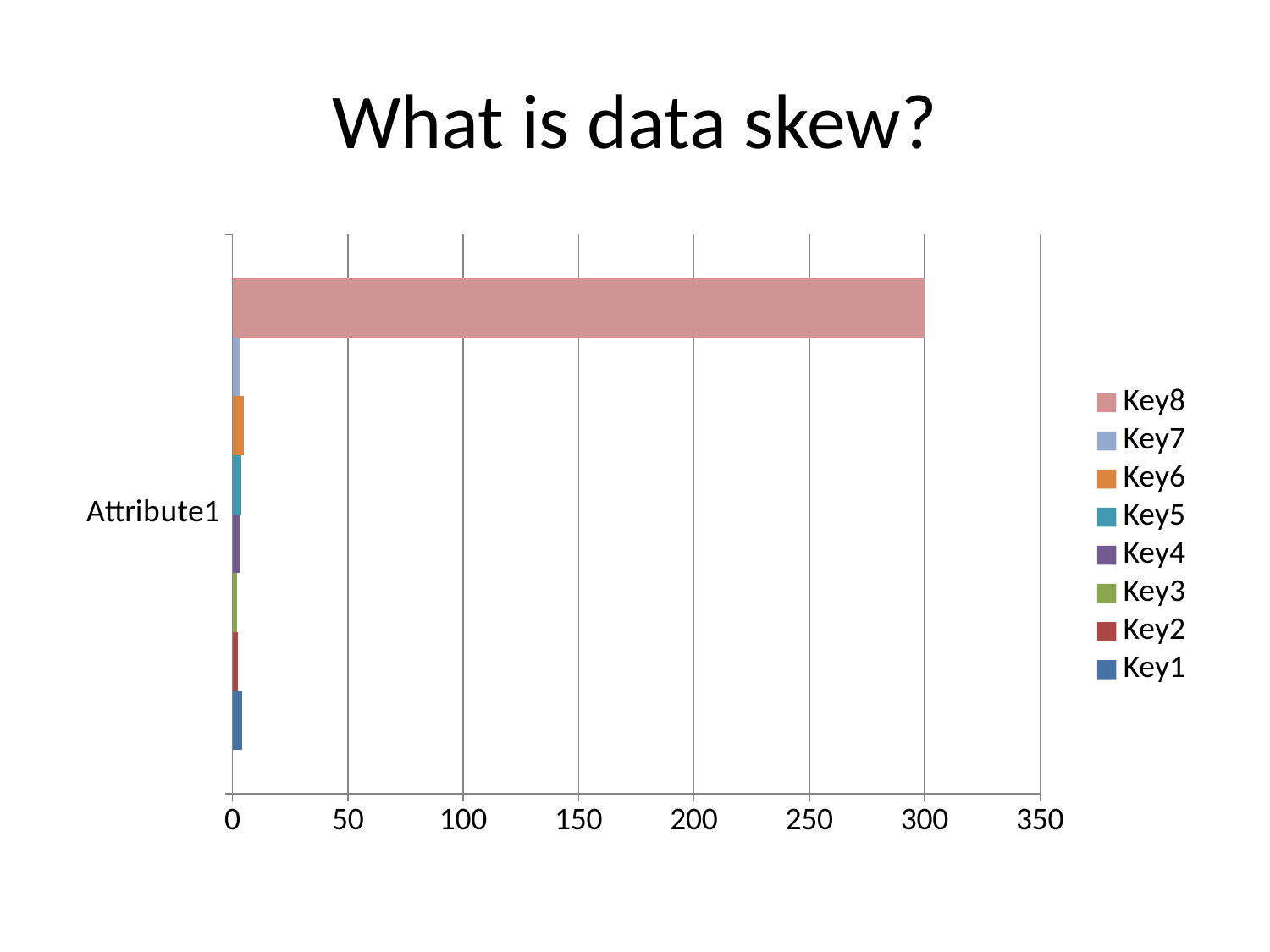
Which is larger for Attribute1, Key8 or Key1? Key8 How many categories are shown on the vertical axis? 1 Which series has the highest value for Attribute1? Key8 Which is larger for Attribute1, Key5 or Key8? Key8 Is the value for Key8 greater or less than 250? greater Is the value for Key6 greater or less than 50? less What is the title of the slide containing the chart? What is data skew? What is the label of the category on the vertical axis? Attribute1 What is the value of Key8 for Attribute1? 300 How many series does the legend list? 8 What kind of chart is shown on the slide? bar chart Is the value for Key1 greater or less than 100? less